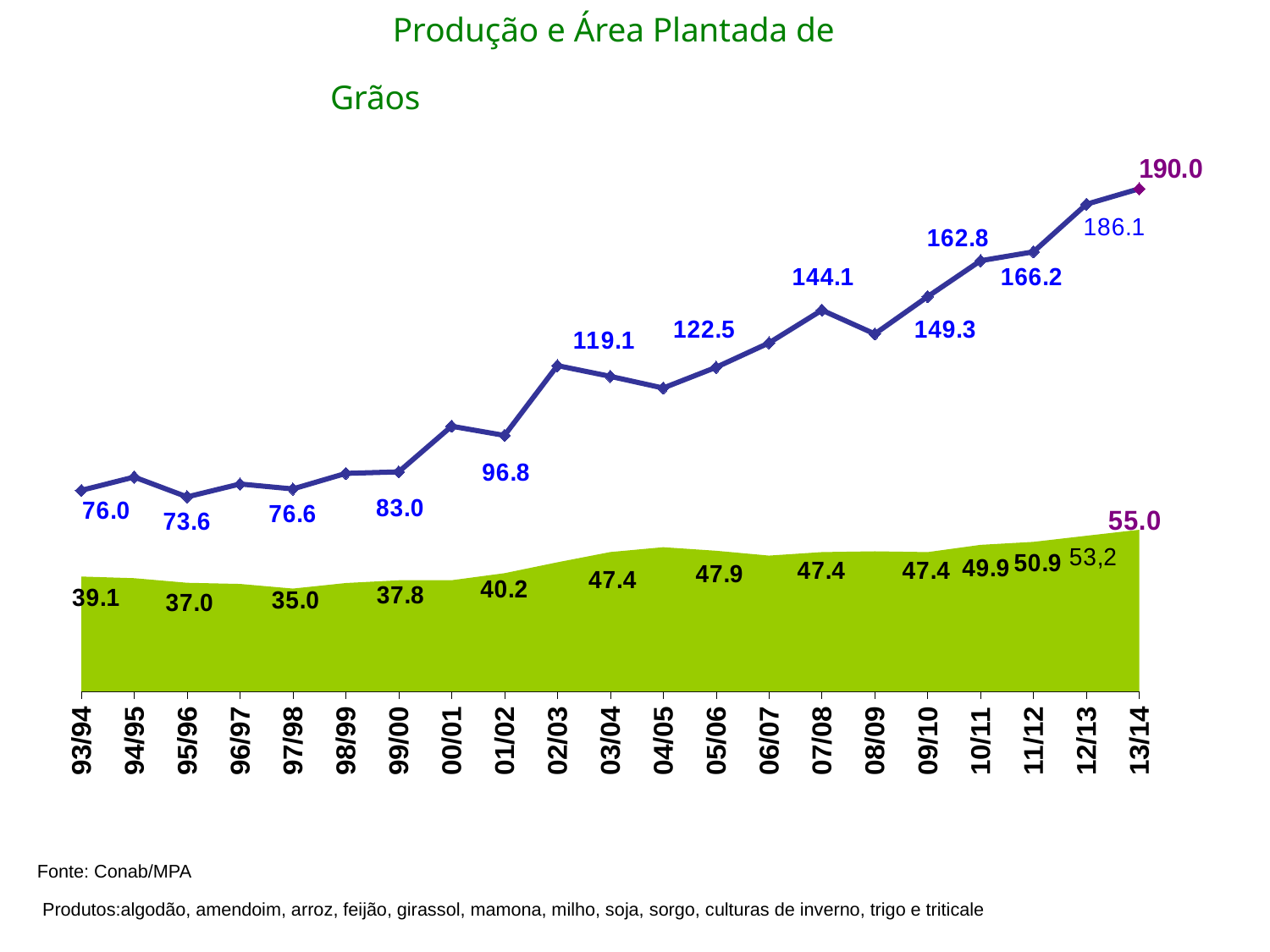
What is the value of the upper line series for 13/14? 190.0 What is the value of the green area series for 93/94? 39.1 Which is larger in the upper line series: the value for 07/08 or for 05/06? 07/08 What is the value of the upper line series for 93/94? 76.0 What is the value of the green area series for 13/14? 55.0 How many seasons are shown on the x axis? 21 Which season has the lowest value in the upper line series? 95/96 Does the upper line series generally rise or fall from 93/94 to 13/14? rise What is the title of the chart? Produção e Área Plantada de Grãos What is the difference between the upper line series values for 13/14 and 93/94? 114.0 What is the value of the upper line series for 12/13? 186.1 Which season has the highest value in the upper line series? 13/14